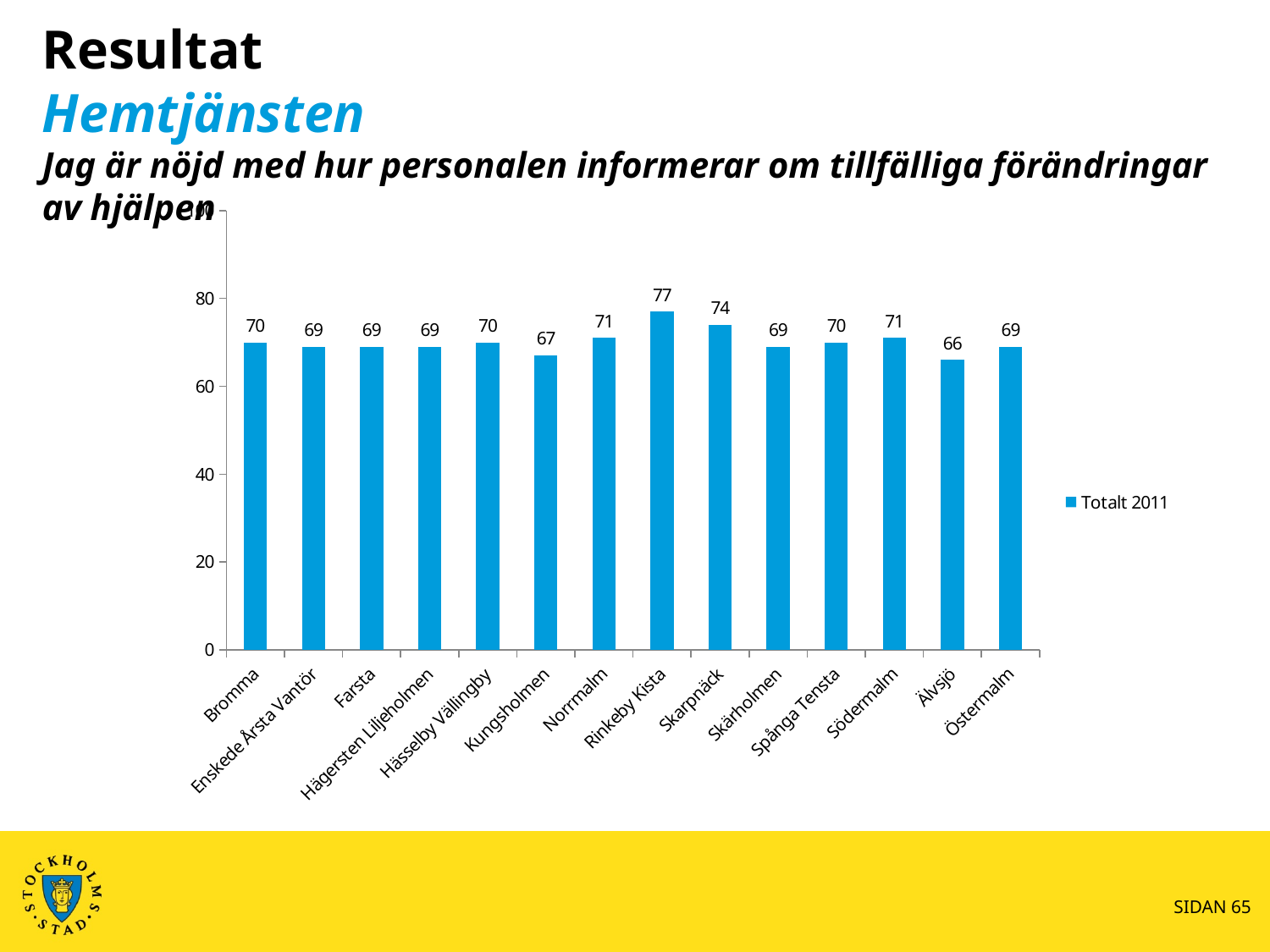
What is the difference between the values for Rinkeby Kista and Älvsjö? 11 Is the value for Bromma greater or less than 60? greater What is the value for Skarpnäck? 74 Which category has the highest value? Rinkeby Kista How many categories are shown on the x axis? 14 How many series does the legend list? 1 Which category has the lowest value? Älvsjö What is the value for Kungsholmen? 67 What kind of chart is shown on the slide? Bar chart What is the legend entry for the series? Totalt 2011 What is the value for Rinkeby Kista? 77 Which is larger, the value for Skarpnäck or the value for Norrmalm? Skarpnäck